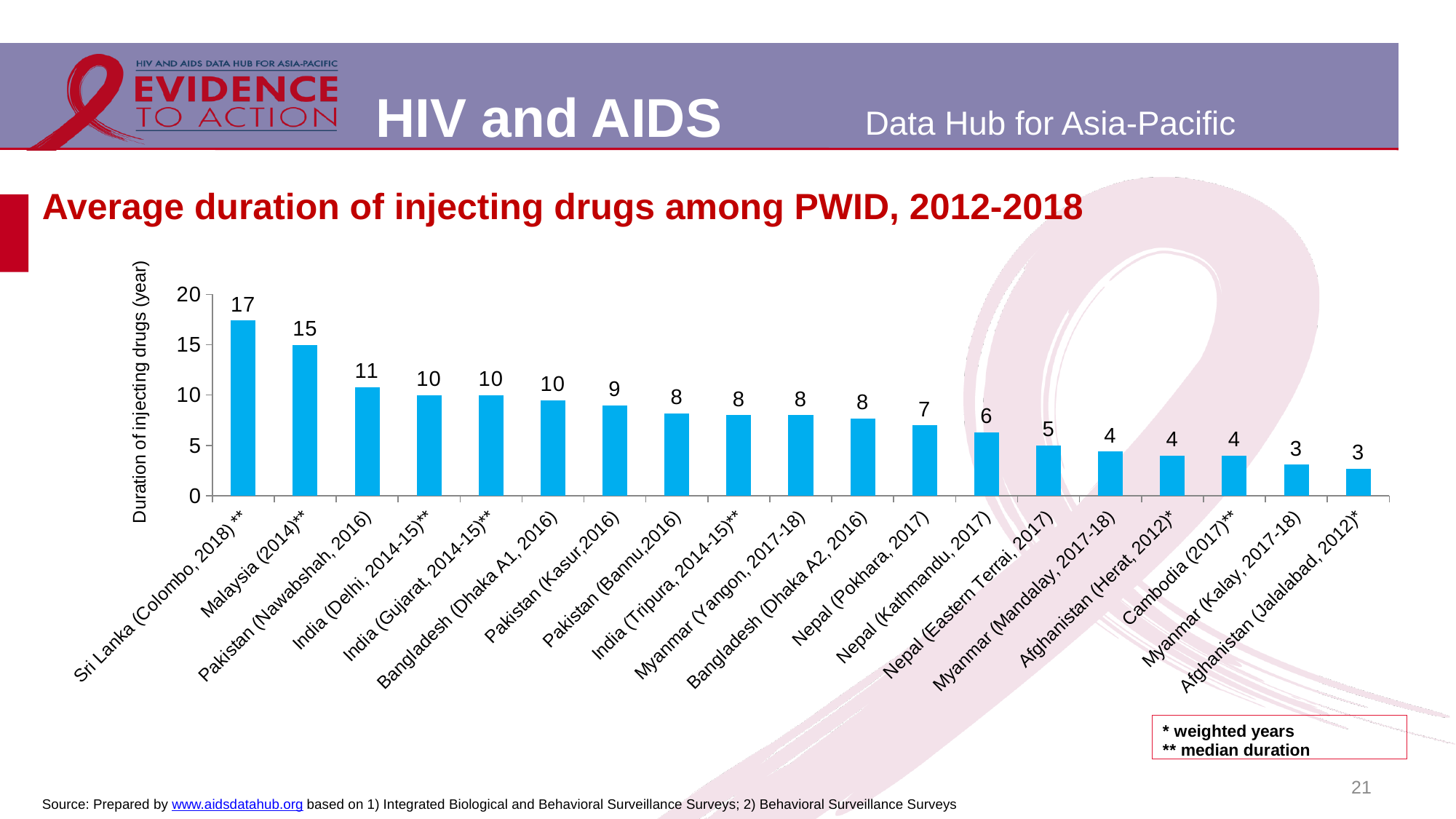
Which is larger, the value for Malaysia (2014) or the value for Pakistan (Nawabshah, 2016)? Malaysia (2014) What kind of chart is shown on the slide? Bar chart What is the value for Pakistan (Nawabshah, 2016)? 11 How many sites are shown in the chart? 19 Which site has the highest average duration of injecting drugs? Sri Lanka (Colombo, 2018) What is the difference between the values for Sri Lanka (Colombo, 2018) and Malaysia (2014)? 2 What is the label on the vertical axis of the chart? Duration of injecting drugs (year) What is the average duration of injecting drugs for Sri Lanka (Colombo, 2018)? 17 Do the values rise or fall from left to right across the chart? Fall What is the value for Nepal (Kathmandu, 2017)? 6 What value is shown for Malaysia (2014)? 15 What is the value for Afghanistan (Jalalabad, 2012)? 3